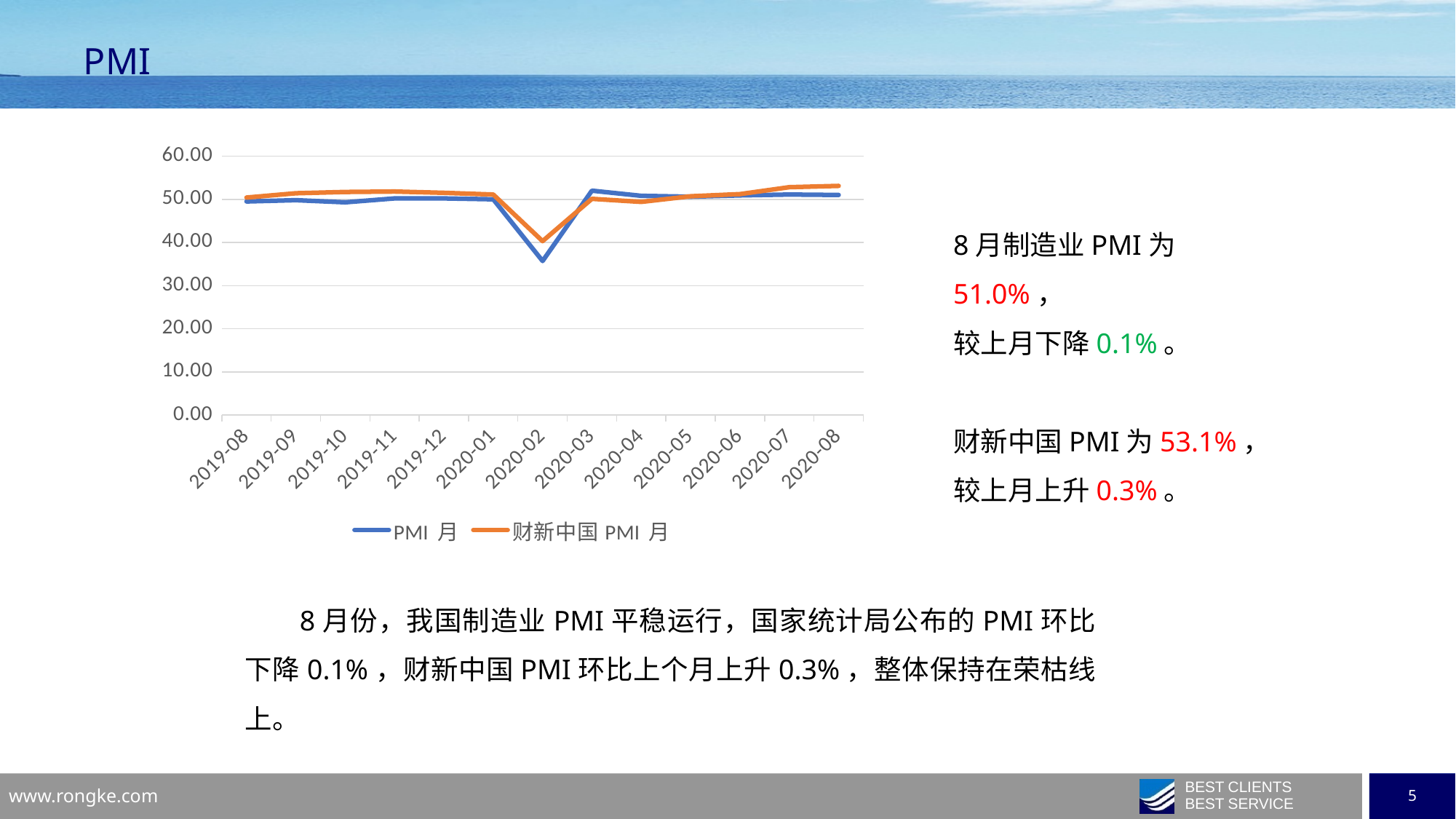
In which month does the PMI 月 series reach its lowest point? 2020-02 What kind of chart is shown on the slide? line chart According to the slide, what is the manufacturing PMI (PMI 月) for August 2020? 51.0% Is the value for PMI 月 in 2020-02 greater or less than 40.00? less Between 2020-02 and 2020-03, does the PMI 月 series rise or fall? rise What colour is the line for the PMI 月 series? blue In 2020-08, which series has the higher value, PMI 月 or 财新中国 PMI 月? 财新中国 PMI 月 In 2020-02, which series has the higher value, PMI 月 or 财新中国 PMI 月? 财新中国 PMI 月 How many series does the chart legend list? 2 Is the value for 财新中国 PMI 月 in 2020-08 greater or less than 50.00? greater In which month does the 财新中国 PMI 月 series reach its lowest point? 2020-02 How many months are plotted along the x axis of the chart? 13